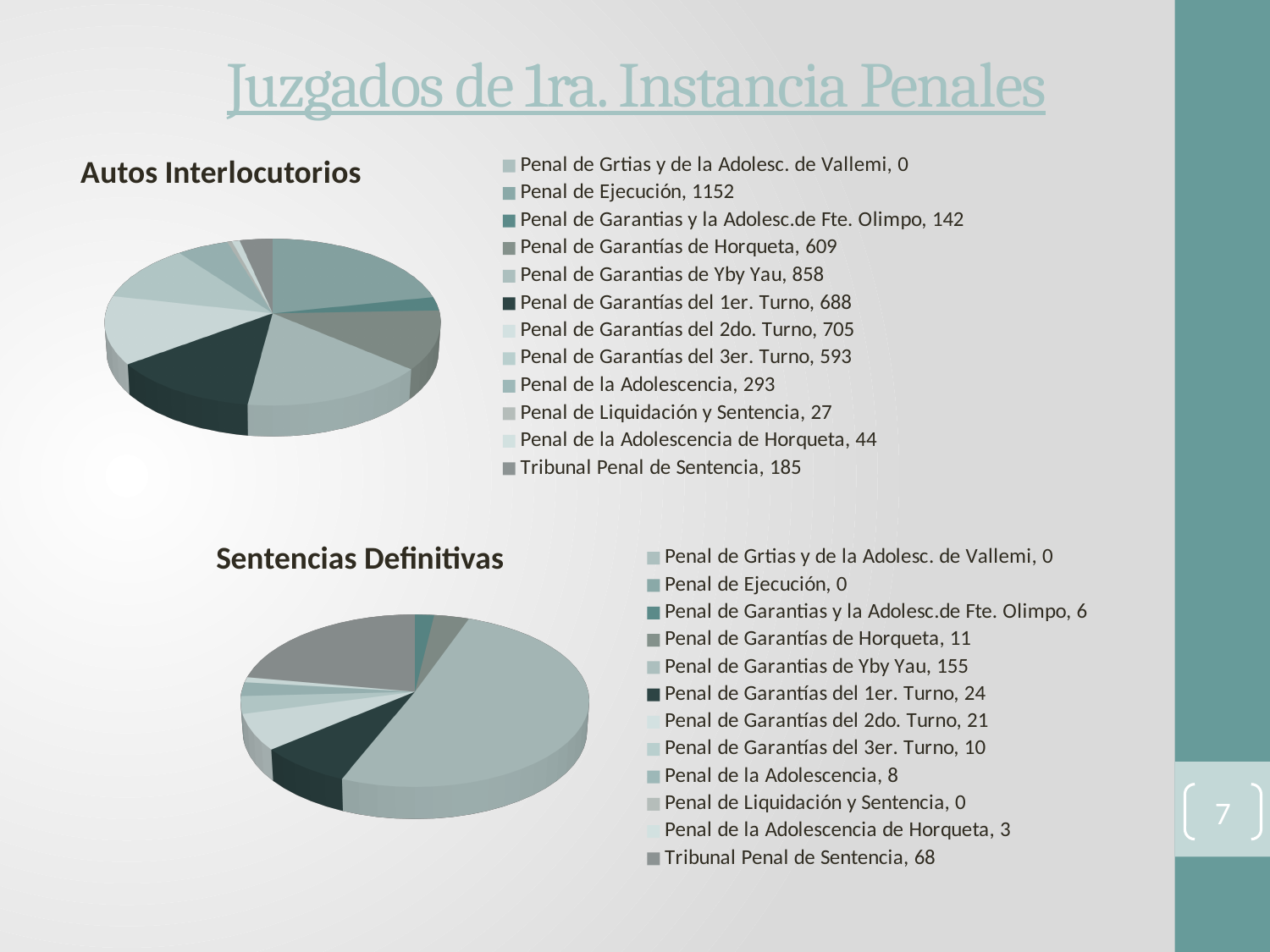
In the Sentencias Definitivas chart, which is larger: Penal de Garantías del 1er. Turno or Penal de Garantías del 2do. Turno? Penal de Garantías del 1er. Turno In the Autos Interlocutorios chart, which category has the highest value? Penal de Ejecución What is the total of all values in the Sentencias Definitivas chart? 306 How many categories does the Autos Interlocutorios chart list? 12 In the Autos Interlocutorios chart, which category has the lowest value? Penal de Grtias y de la Adolesc. de Vallemi In the Autos Interlocutorios chart, what is the difference between Penal de Ejecución and Penal de Garantias de Yby Yau? 294 In the Sentencias Definitivas chart, what is the value for Tribunal Penal de Sentencia? 68 What type of chart is used for Autos Interlocutorios? Pie chart In the Autos Interlocutorios chart, what is the value for Penal de Garantías del 2do. Turno? 705 In the Autos Interlocutorios chart, what is the value for Penal de Ejecución? 1152 In the Sentencias Definitivas chart, which category has the highest value? Penal de Garantias de Yby Yau In the Sentencias Definitivas chart, what is the difference between Tribunal Penal de Sentencia and Penal de Garantías del 1er. Turno? 44